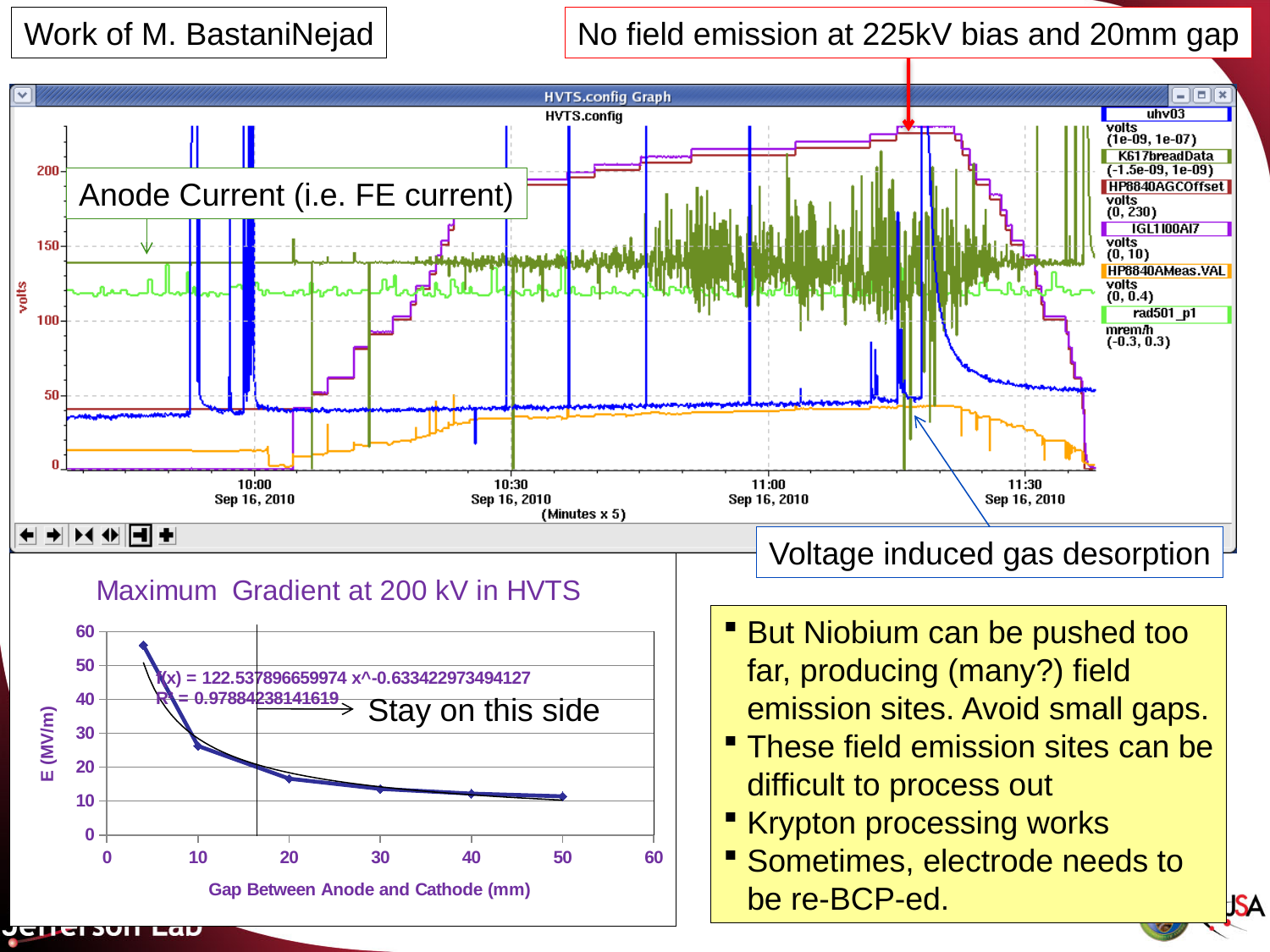
What kind of chart is the bottom chart 'Maximum Gradient at 200 kV in HVTS'? line chart What is the title of the bottom chart? Maximum Gradient at 200 kV in HVTS In the bottom chart 'Maximum Gradient at 200 kV in HVTS', how many data points are plotted? 6 In the top chart 'HVTS.config Graph', how many series does the legend list? 6 In the bottom chart 'Maximum Gradient at 200 kV in HVTS', does E (MV/m) rise or fall as the gap increases? fall In the bottom chart 'Maximum Gradient at 200 kV in HVTS', what R² value is shown for the fitted curve? 0.97884238141619 In the bottom chart 'Maximum Gradient at 200 kV in HVTS', which gap has the highest E value: 10 mm or 40 mm? 10 mm In the top chart 'HVTS.config Graph', what is the y-axis label? volts In the bottom chart 'Maximum Gradient at 200 kV in HVTS', is the value of E at the smallest gap plotted greater or less than 50? greater In the bottom chart 'Maximum Gradient at 200 kV in HVTS', is the value of E at a 10 mm gap greater or less than 30? less In the bottom chart 'Maximum Gradient at 200 kV in HVTS', what is the x-axis label? Gap Between Anode and Cathode (mm) In the bottom chart 'Maximum Gradient at 200 kV in HVTS', is the value of E at a 50 mm gap greater or less than 20? less